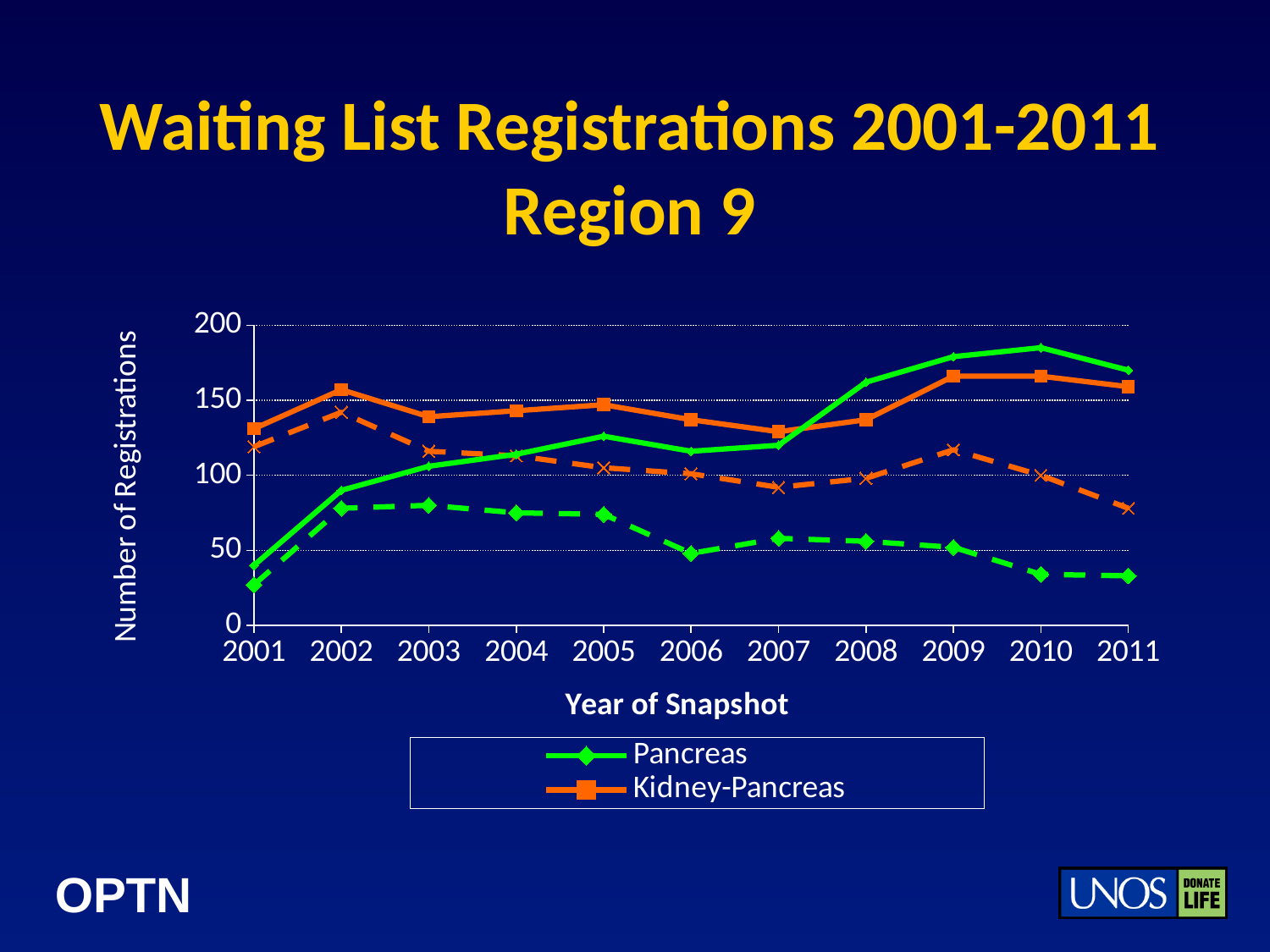
In which year does the Pancreas series have its lowest value? 2001 How many years are plotted along the x axis? 11 What is the title of the x axis? Year of Snapshot In which year does the Pancreas series reach its highest value? 2010 What type of chart is shown on the slide? Line chart In 2010, which series has the higher value, Pancreas or Kidney-Pancreas? Pancreas Is the value for Kidney-Pancreas in 2002 greater or less than 150? greater How many series does the legend list? 2 Is the value for Pancreas in 2010 greater or less than 150? greater Is the value for Pancreas in 2001 greater or less than 50? less In 2001, which series has the higher value, Pancreas or Kidney-Pancreas? Kidney-Pancreas